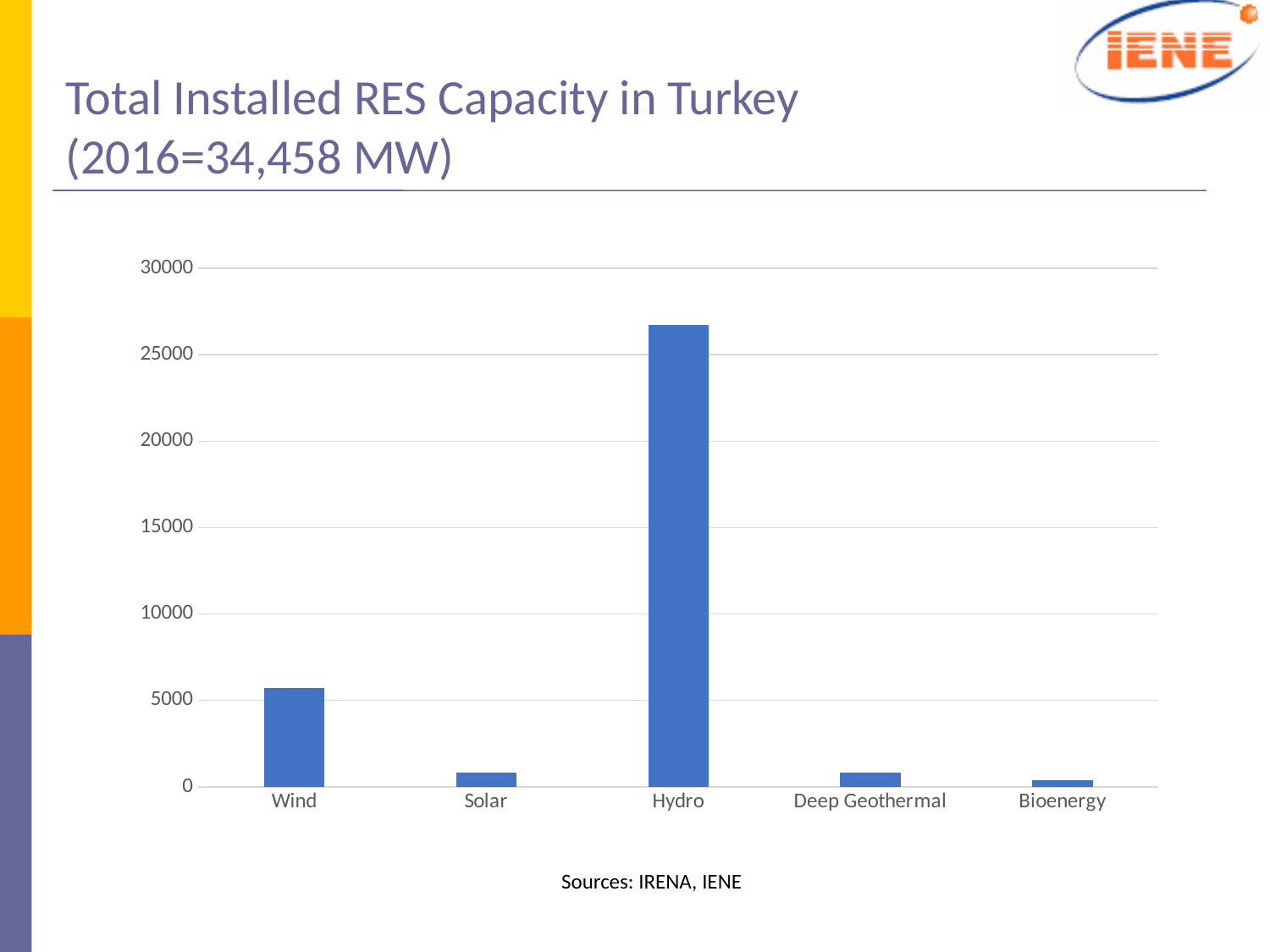
What sources are cited below the chart? IRENA, IENE Is the value for Wind greater or less than 10000? less Which is larger, the value for Wind or the value for Solar? Wind How many categories are shown on the x axis of the chart? 5 Which category has the lowest installed capacity in the chart? Bioenergy Which category has the highest installed capacity in the chart? Hydro What kind of chart is shown on the slide? Bar chart Which is larger, the value for Deep Geothermal or the value for Hydro? Hydro Is the value for Hydro greater or less than 25000? greater Is the value for Solar greater or less than 5000? less